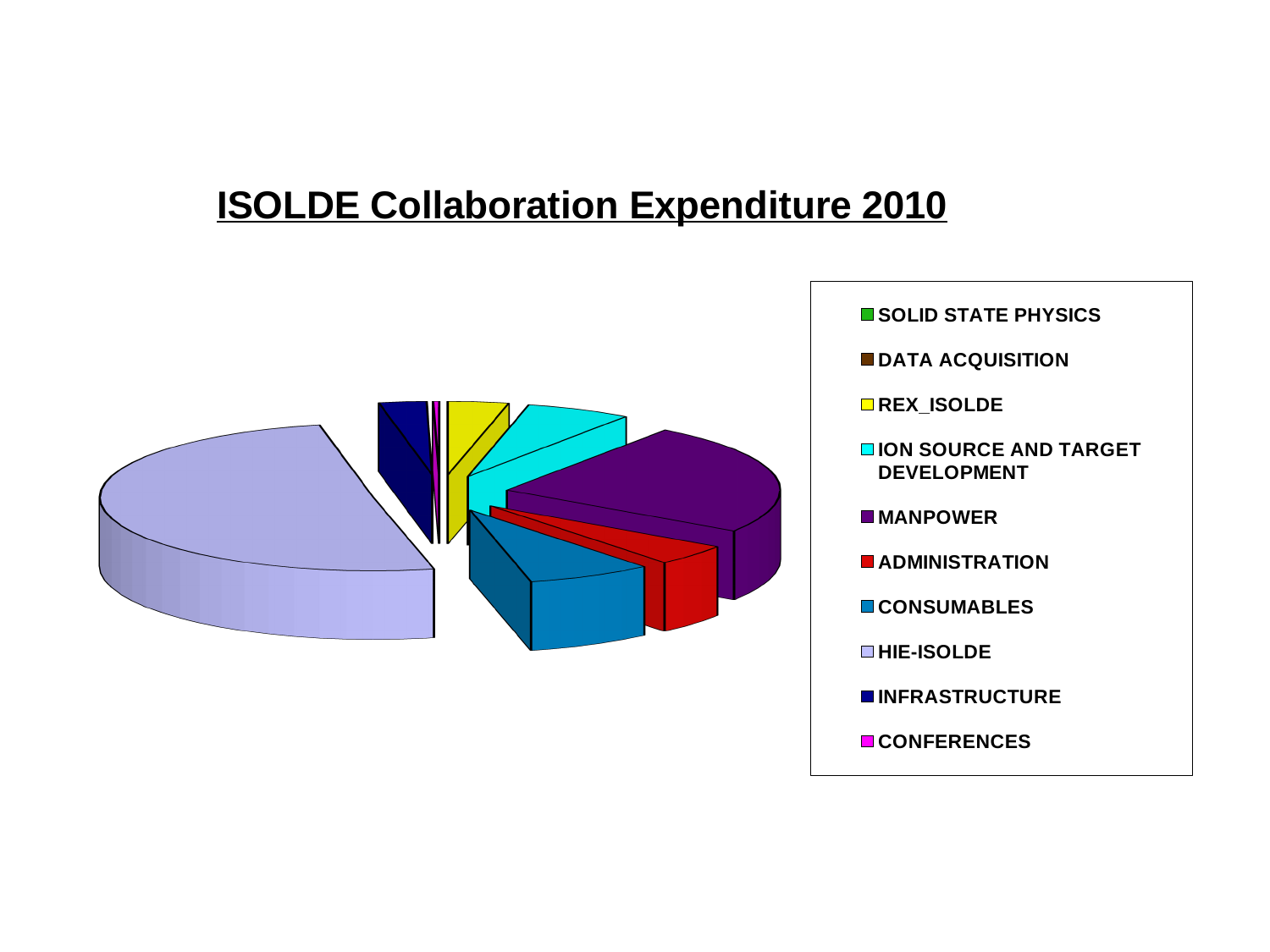
Which slice is larger, MANPOWER or REX_ISOLDE? MANPOWER Which slice is larger, HIE-ISOLDE or MANPOWER? HIE-ISOLDE Which slice is larger, CONSUMABLES or CONFERENCES? CONSUMABLES Which category has the largest slice of the pie? HIE-ISOLDE How many categories are listed in the legend? 10 What is the title of the chart? ISOLDE Collaboration Expenditure 2010 What kind of chart is shown on the slide? Pie chart Which category is shown in purple in the legend? MANPOWER